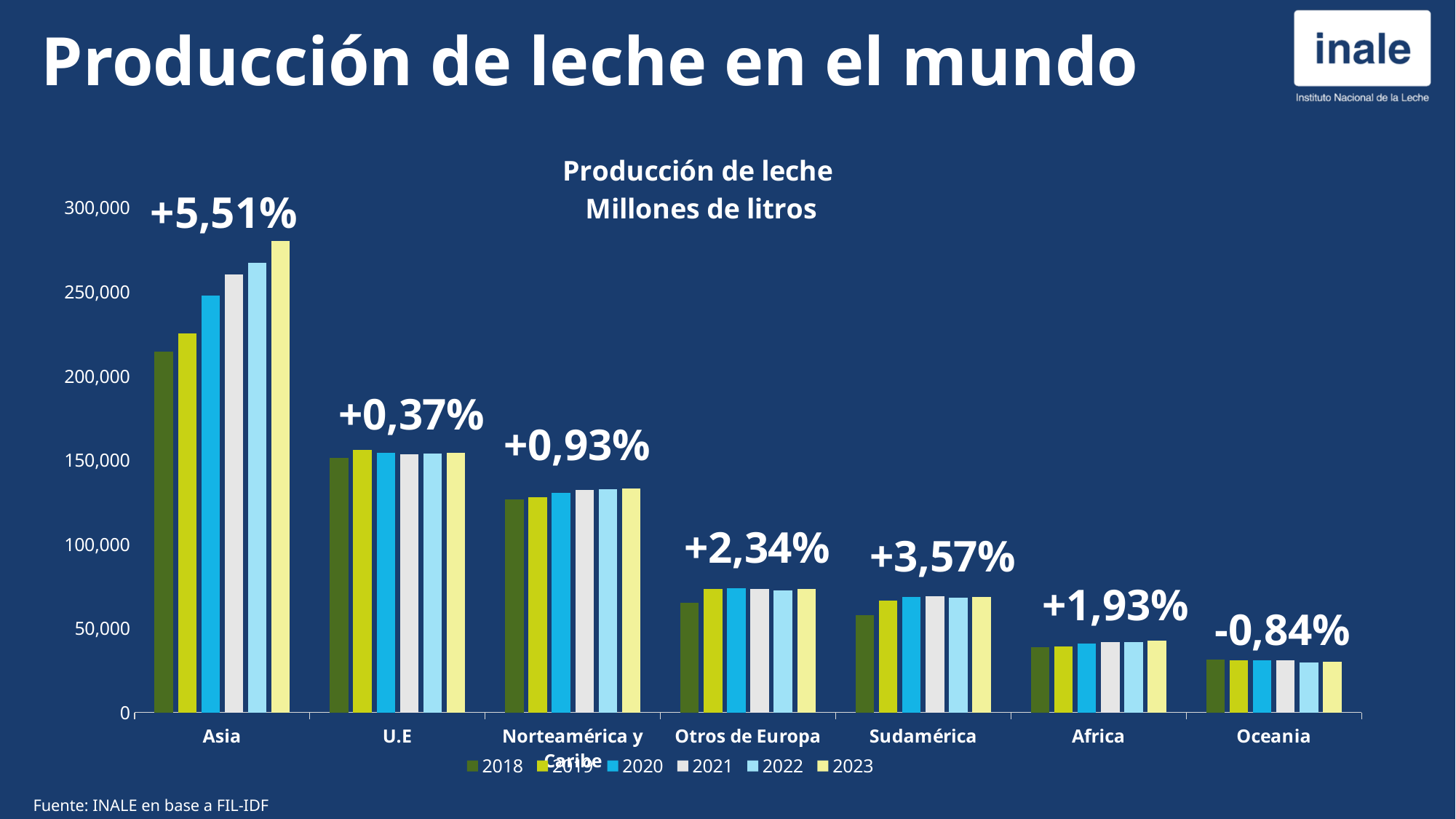
How many series does the chart legend list? 6 What percentage change is printed above the Oceania group of bars? -0,84% Is the value for Africa in 2023 greater or less than 50,000? less Is the value for Asia in 2023 greater or less than 250,000? greater Do the values for Asia rise or fall from 2018 to 2023? rise What kind of chart is shown on the slide? bar chart Which region has the highest milk production in the chart? Asia What percentage change is printed above the Asia group of bars? +5,51% What percentage change is printed above the Sudamérica group of bars? +3,57% Which region has a larger milk production in 2023, Sudamérica or Africa? Sudamérica How many regions (categories) are shown on the x axis of the chart? 7 Which region has the lowest milk production in the chart? Oceania